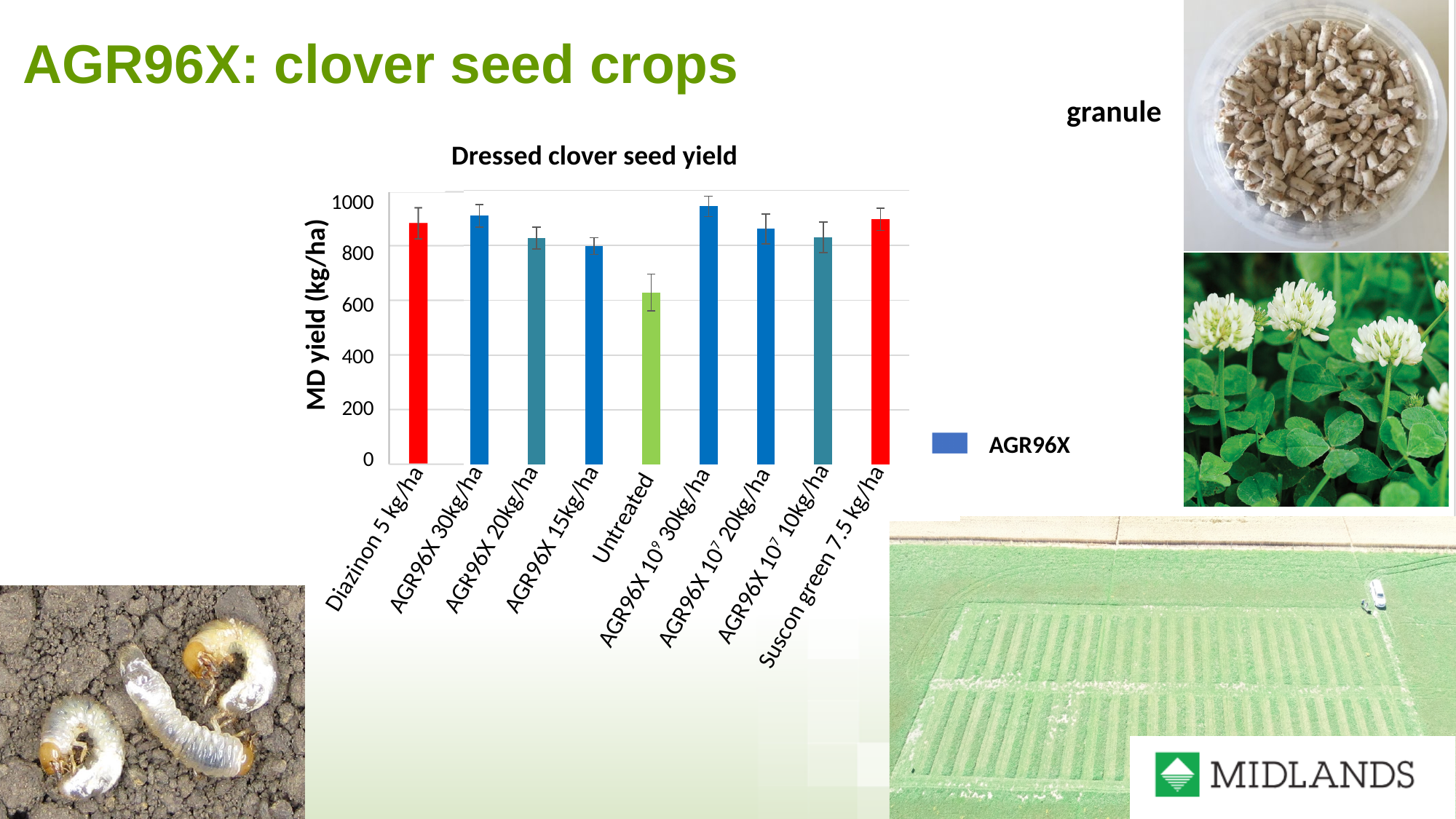
Which treatment has the lowest dressed clover seed yield? Untreated What type of chart is shown on the slide? bar chart What is the label on the y-axis of the chart? MD yield (kg/ha) How many treatment categories are plotted on the x-axis? 9 Which has the larger yield, Untreated or Diazinon 5 kg/ha? Diazinon 5 kg/ha Which has the larger yield, AGR96X 30kg/ha or AGR96X 15kg/ha? AGR96X 30kg/ha How many series does the legend list? 1 Is the yield for AGR96X 15kg/ha greater or less than 600 kg/ha? greater What is the title of the chart? Dressed clover seed yield Is the yield for Diazinon 5 kg/ha greater or less than 800 kg/ha? greater Is the yield for Untreated greater or less than 800 kg/ha? less Which treatment has the highest dressed clover seed yield? AGR96X 10^9 30kg/ha